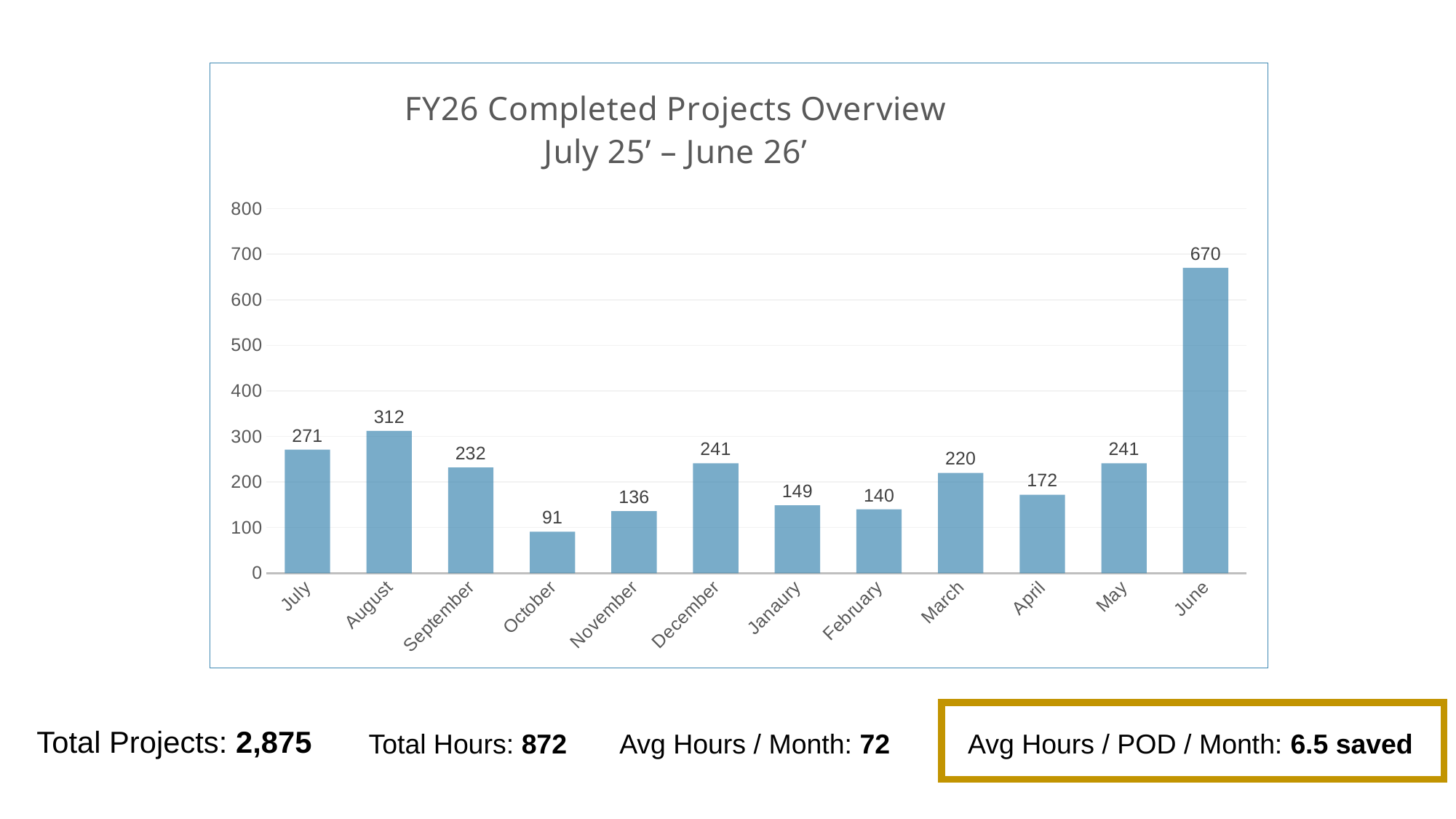
What kind of chart is shown? Bar chart What is the value for August? 312 Which is larger, the value for September or the value for April? September What is the value for October? 91 What is the difference between the values for July and November? 135 Which month has the highest value? June What is the value for March? 220 Is the value for June greater or less than 600? greater Which month has the lowest value? October How many months are shown on the x axis? 12 What is the difference between the values for June and August? 358 What is the title of the chart? FY26 Completed Projects Overview July 25' – June 26'